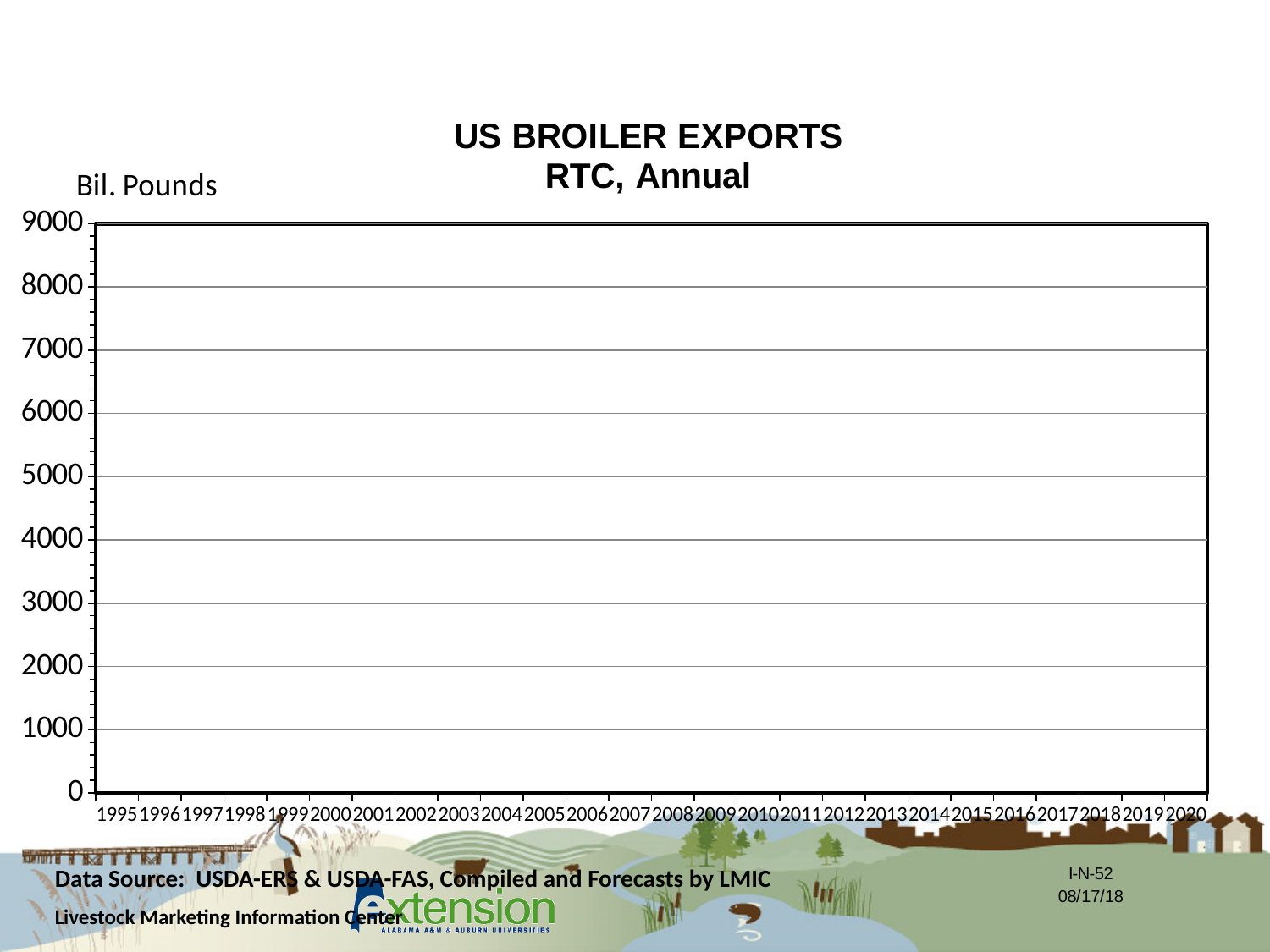
How many years are labeled along the x axis of the chart? 26 What is the highest value shown on the vertical axis of the chart? 9000 What is the last year labeled on the x axis of the chart? 2020 What is the title of the chart? US BROILER EXPORTS RTC, Annual What is the first year labeled on the x axis of the chart? 1995 What unit label is shown above the vertical axis of the chart? Bil. Pounds